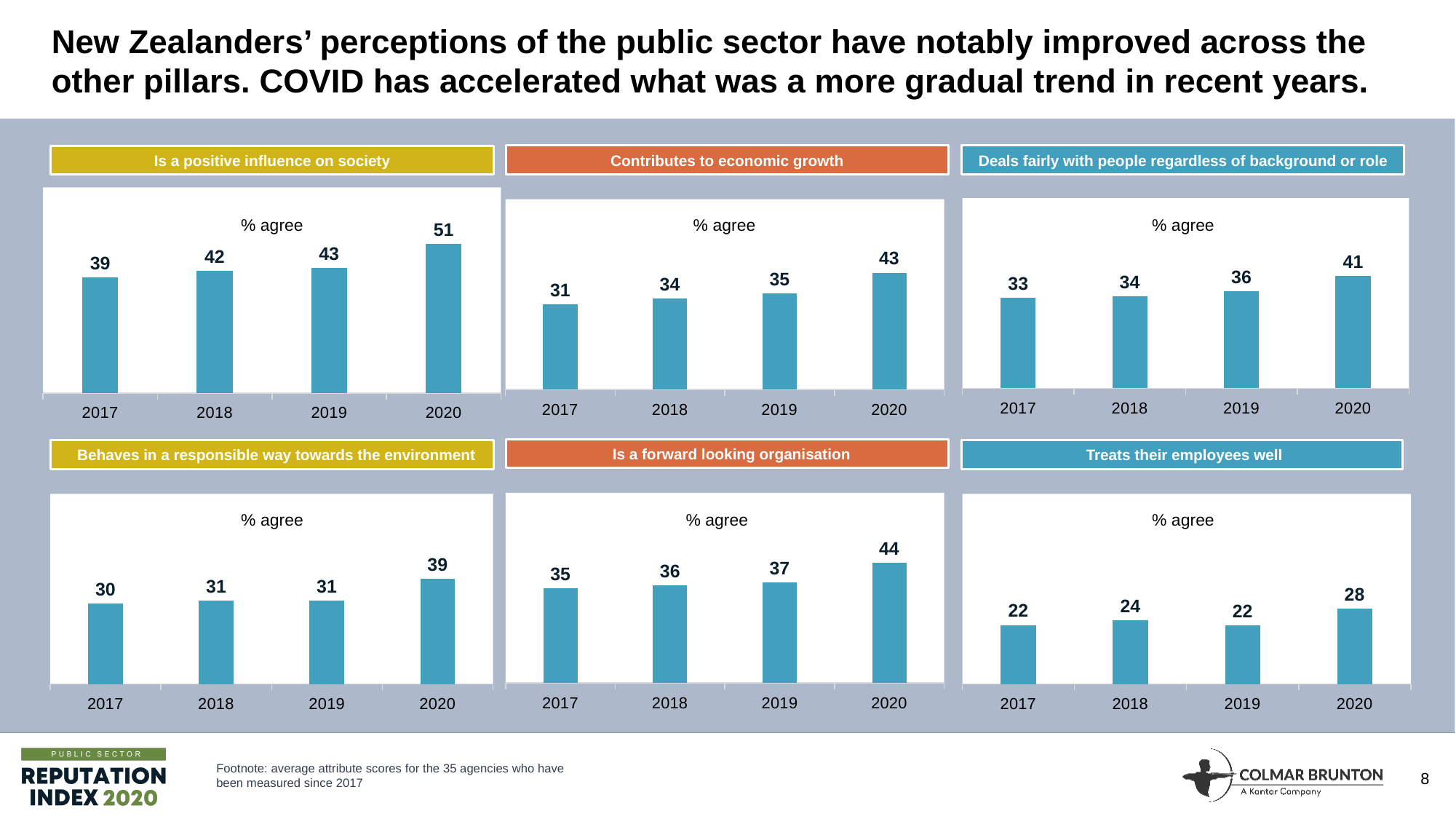
In the 'Treats their employees well' chart, what is the lowest value shown? 22 In the 'Is a forward looking organisation' chart, do the values rise or fall from 2017 to 2020? Rise What type of chart is used in the 'Treats their employees well' panel? Bar chart In the 'Treats their employees well' chart, what is the value for 2018? 24 In the 'Contributes to economic growth' chart, what is the value for 2017? 31 In the 'Behaves in a responsible way towards the environment' chart, what is the difference between the 2020 and 2019 values? 8 How many charts are shown on the slide? 6 In the 'Is a positive influence on society' chart, what is the % agree value for 2020? 51 In the 'Deals fairly with people regardless of background or role' chart, which year has the highest value? 2020 How many years are plotted in the 'Contributes to economic growth' chart? 4 In the 'Is a forward looking organisation' chart, which is larger, the value for 2018 or the value for 2020? 2020 In the 'Is a positive influence on society' chart, what is the difference between the 2020 and 2017 values? 12